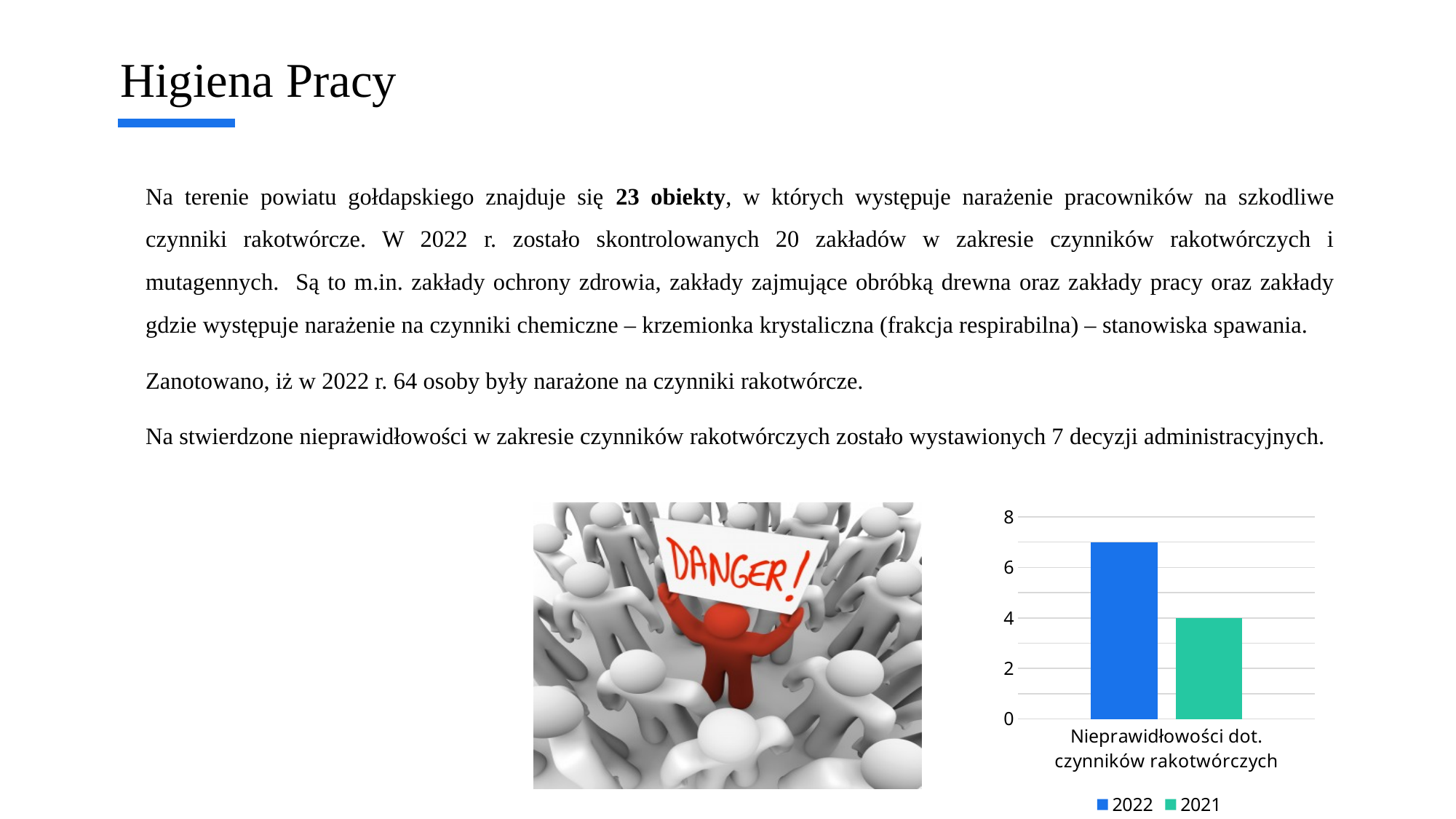
Which series has the highest bar in the chart? 2022 Is the value of the 2022 bar greater or less than 8? less What is the value of the 2021 bar for Nieprawidłowości dot. czynników rakotwórczych? 4 Is the value of the 2022 bar greater or less than 6? greater What is the category label shown on the x axis of the chart? Nieprawidłowości dot. czynników rakotwórczych What kind of chart is shown on the slide? bar chart What colour is the bar for the 2022 series? blue Which series has the larger value, 2022 or 2021? 2022 Which series has the lowest bar in the chart? 2021 What are the entries listed in the chart legend? 2022, 2021 How many series does the chart legend list? 2 How many categories are shown on the x axis of the chart? 1